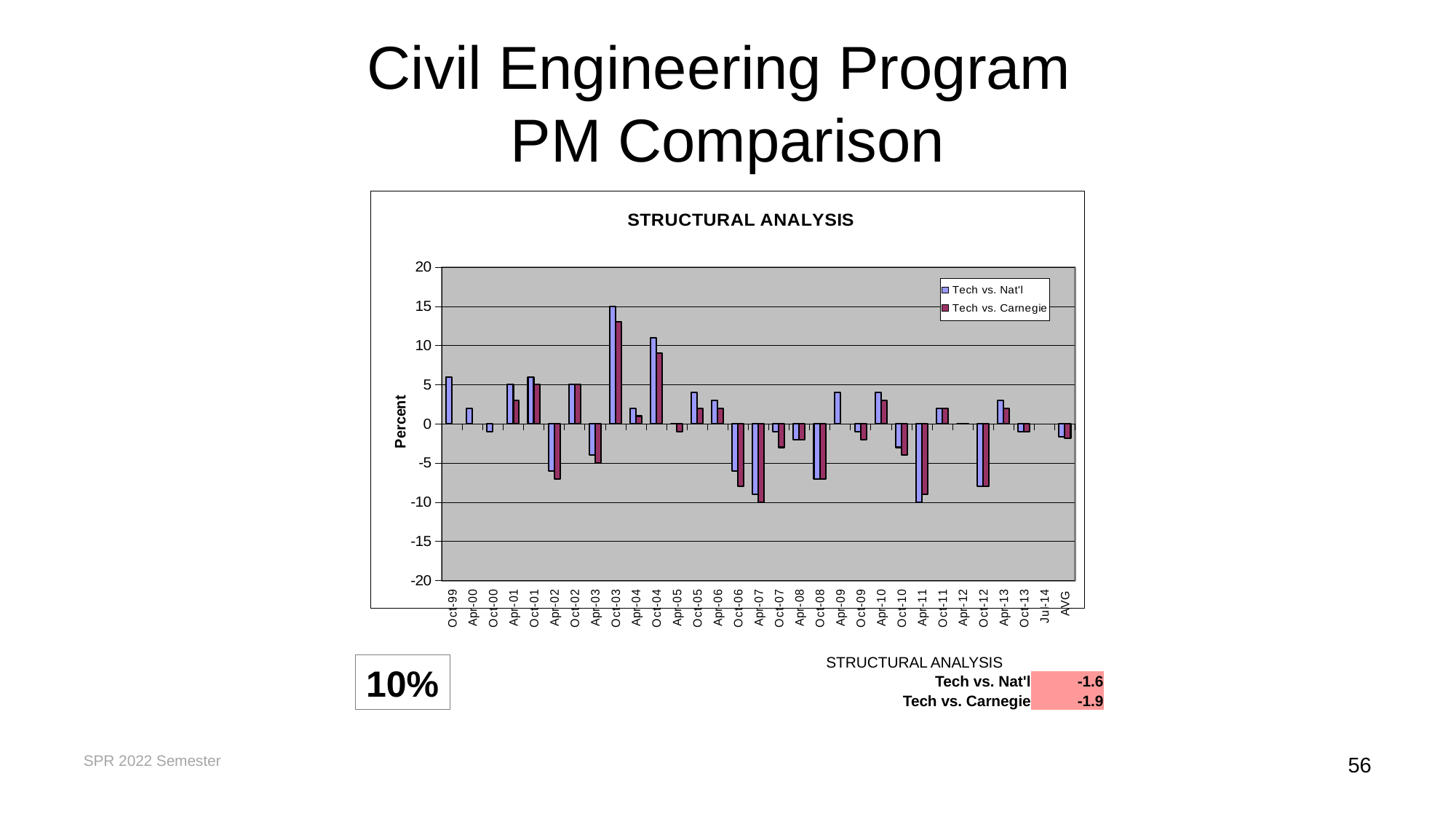
What is the label on the vertical axis of the chart? Percent What is the AVG value for Tech vs. Nat'l? -1.6 At Oct-03, which series has the larger value, Tech vs. Nat'l or Tech vs. Carnegie? Tech vs. Nat'l At which period does the Tech vs. Nat'l series reach its highest value? Oct-03 What is the difference between the AVG values for Tech vs. Nat'l and Tech vs. Carnegie? 0.3 What kind of chart is shown on the slide? bar chart What is the title of the chart? STRUCTURAL ANALYSIS How many series does the chart's legend list? 2 Is the Tech vs. Carnegie value for Apr-07 greater or less than -5? less What is the AVG value for Tech vs. Carnegie? -1.9 Which of the two AVG values is larger, Tech vs. Nat'l or Tech vs. Carnegie? Tech vs. Nat'l Is the Tech vs. Nat'l value for Oct-03 greater or less than 10? greater